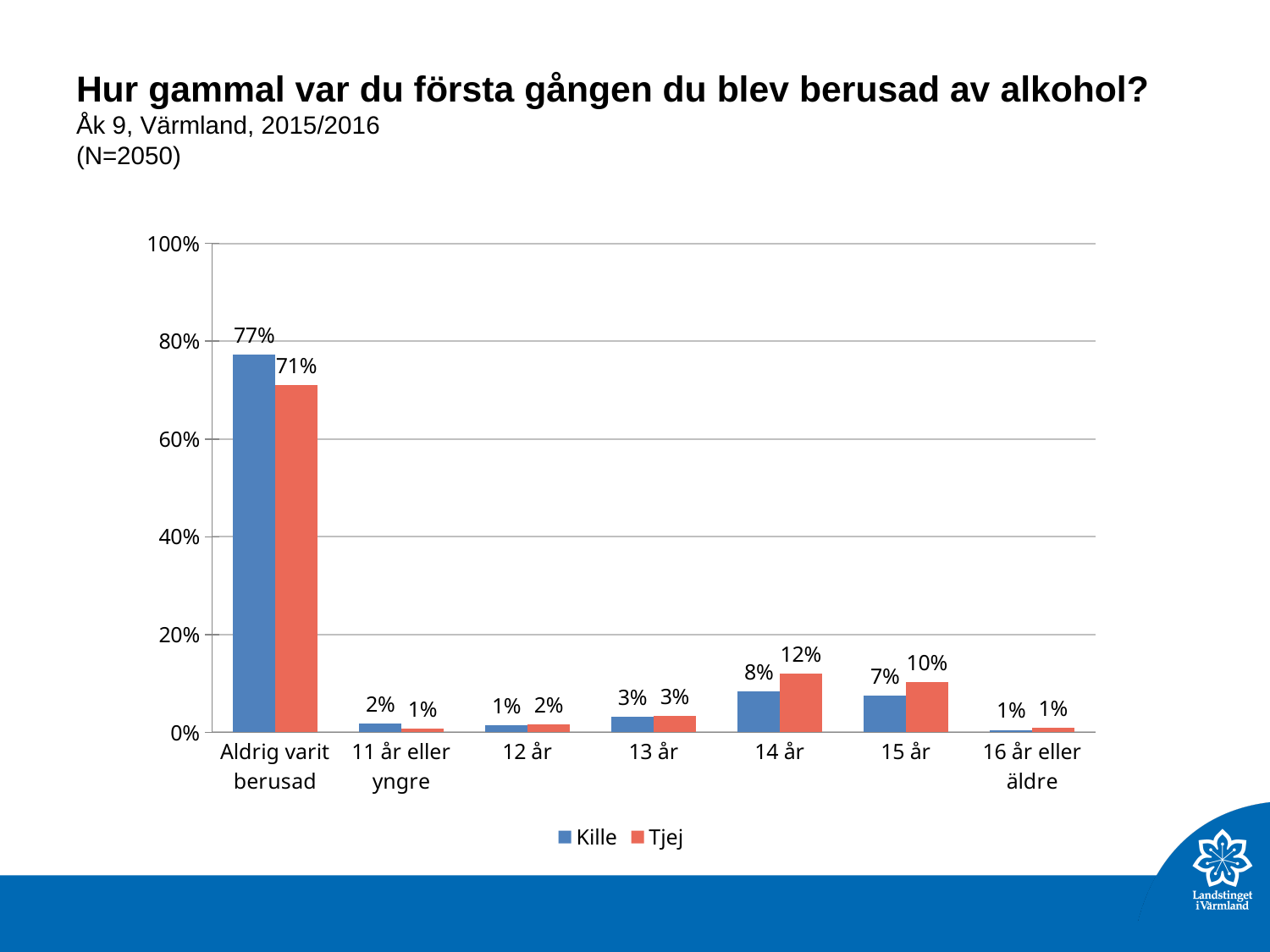
Which is larger in the '15 år' category, Kille or Tjej? Tjej What is the value for Kille in the 'Aldrig varit berusad' category? 77% What is the value for Tjej in the '14 år' category? 12% How many categories are shown on the x axis? 7 What is the sample size (N) stated on the slide? N=2050 What kind of chart is shown on the slide? Bar chart Which category has the highest value for Tjej? Aldrig varit berusad What is the difference between the Tjej and Kille values in the '14 år' category? 4 percentage points What is the difference between the Kille and Tjej values in the 'Aldrig varit berusad' category? 6 percentage points How many series does the legend list? 2 What is the value for Kille in the '15 år' category? 7% Is the value for Tjej in 'Aldrig varit berusad' greater or less than 80%? less